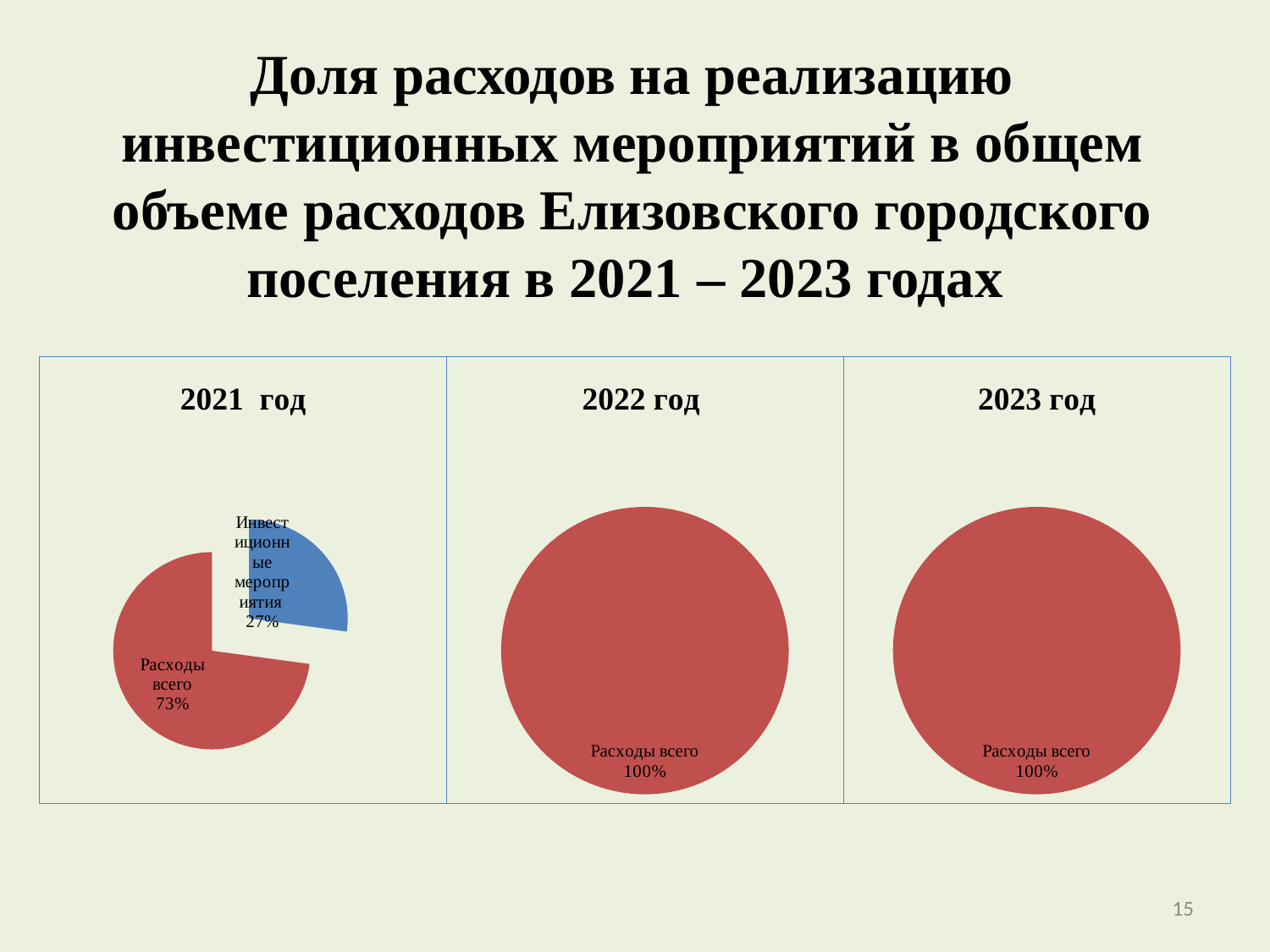
In the "2023 год" chart, what share is labelled for "Расходы всего"? 100% In the "2021 год" chart, what share is labelled for "Расходы всего"? 73% How many slices does the "2021 год" chart have? 2 In the "2022 год" chart, what share is labelled for "Расходы всего"? 100% In the "2021 год" chart, what is the difference in percentage points between "Расходы всего" and "Инвестиционные мероприятия"? 46 How many pie charts are shown on the slide? 3 In the "2021 год" chart, which is larger: "Расходы всего" or "Инвестиционные мероприятия"? Расходы всего What kind of chart is the "2022 год" chart? Pie chart In the "2021 год" chart, which slice is the largest? Расходы всего In the "2021 год" chart, which slice is the smallest? Инвестиционные мероприятия In the "2021 год" chart, what colour is the "Инвестиционные мероприятия" slice? Blue